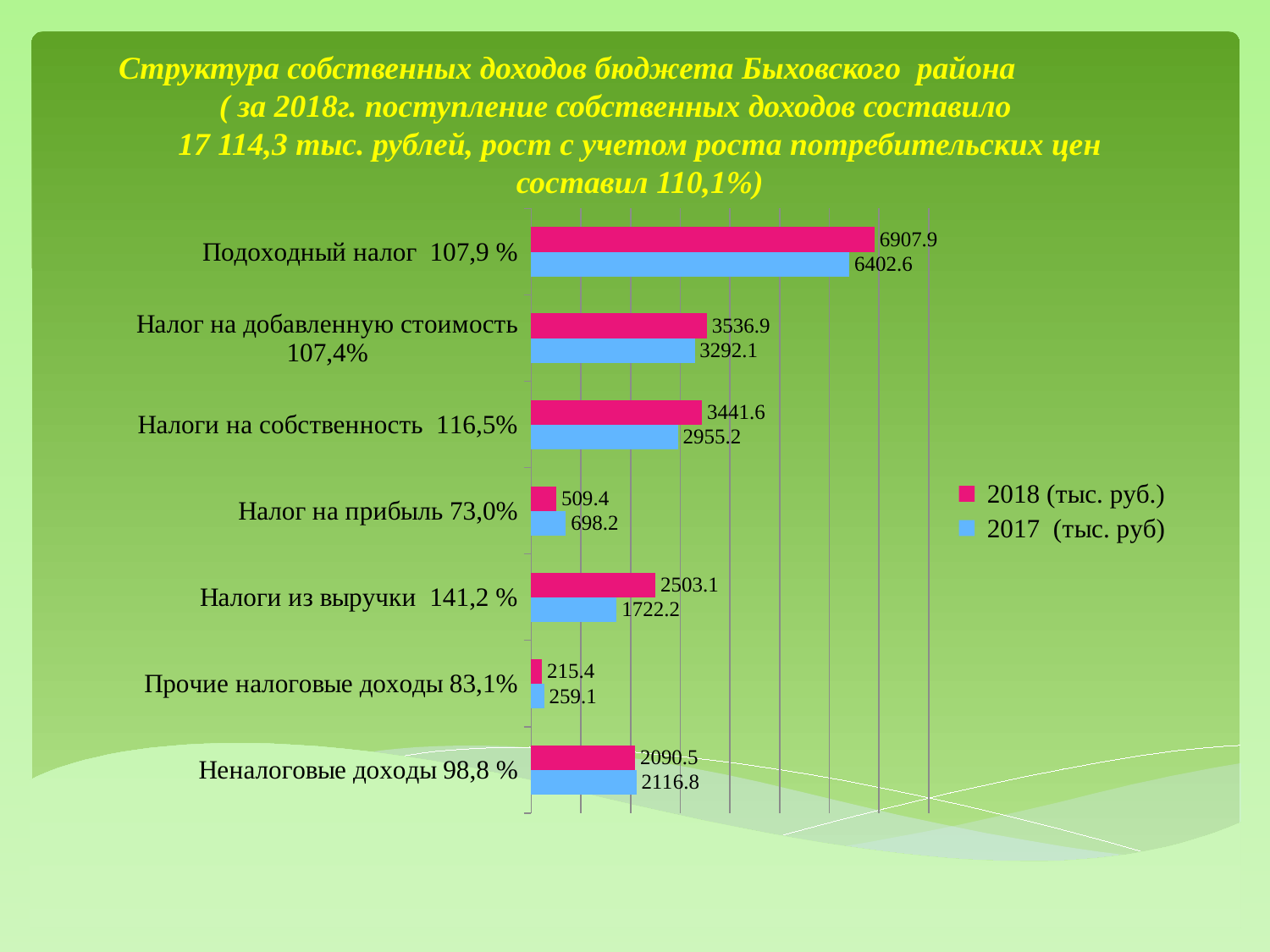
What is the 2018 (тыс. руб.) value for Подоходный налог? 6907.9 How many categories are plotted in the chart? 7 What is the difference between the 2018 and 2017 values for Налоги из выручки? 780.9 Which colour represents the 2018 (тыс. руб.) series in the chart? Pink (magenta) Which category has the highest 2018 (тыс. руб.) value? Подоходный налог What is the 2018 (тыс. руб.) value for Налоги из выручки? 2503.1 What is the 2017 (тыс. руб) value for Прочие налоговые доходы? 259.1 For Налог на прибыль, which is larger: the 2018 value or the 2017 value? 2017 What type of chart is shown on the slide? Bar chart Which category has the lowest 2017 (тыс. руб) value? Прочие налоговые доходы What is the 2017 (тыс. руб) value for Налоги на собственность? 2955.2 How many series does the legend list? 2